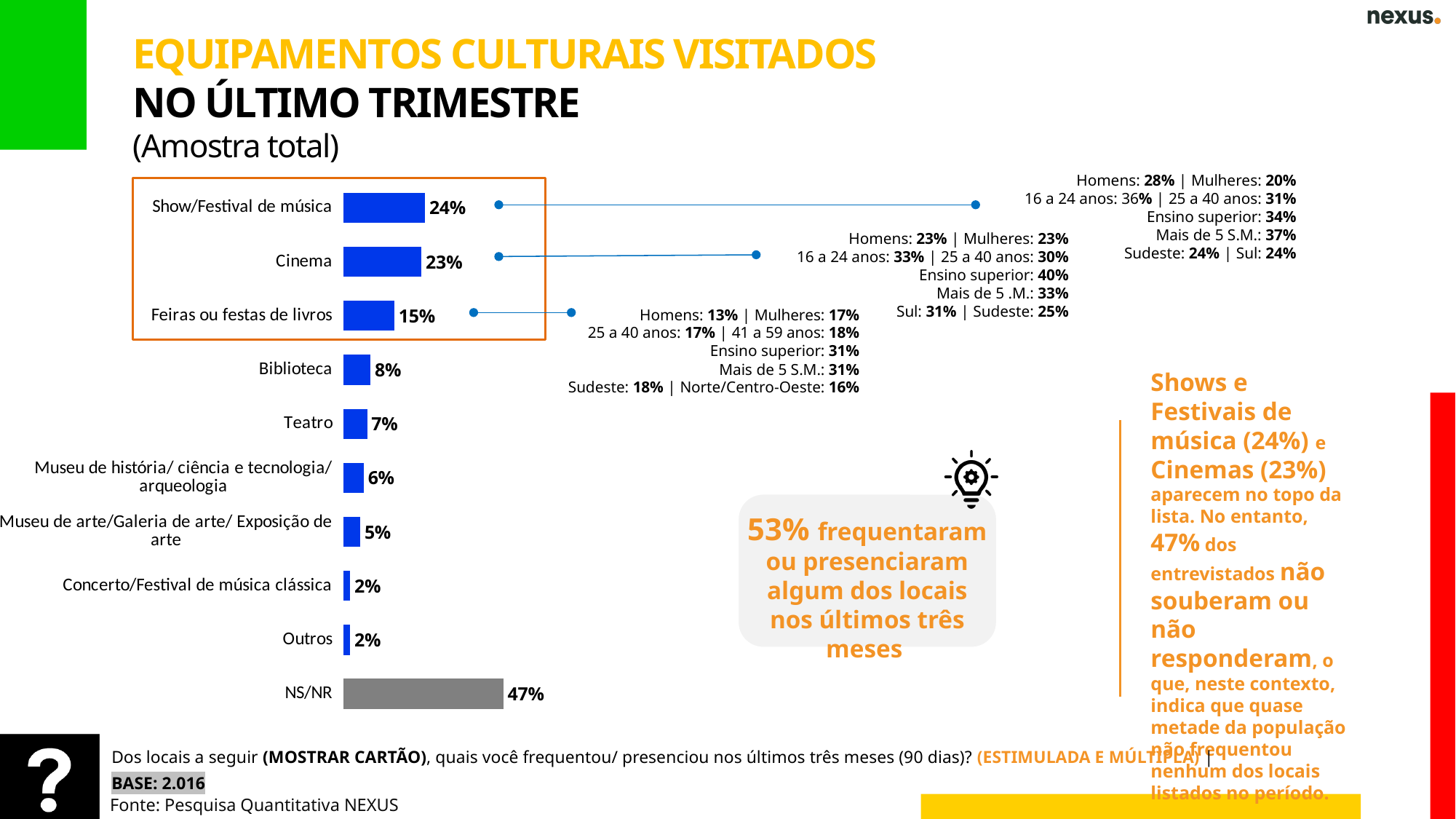
What is the difference between the values for Feiras ou festas de livros and Biblioteca? 7% Which bar in the chart is coloured grey rather than blue? NS/NR What is the value for NS/NR? 47% Which category has the highest value among the blue bars? Show/Festival de música What is the difference between the values for Show/Festival de música and Cinema? 1% What is the value for Biblioteca? 8% Which is larger, the value for Teatro or the value for Museu de arte/Galeria de arte/ Exposição de arte? Teatro How many categories are shown in the chart? 10 What is the value for Cinema? 23% What is the value for Feiras ou festas de livros? 15% What kind of chart is shown on the slide? bar chart Which category has the highest value in the chart? NS/NR